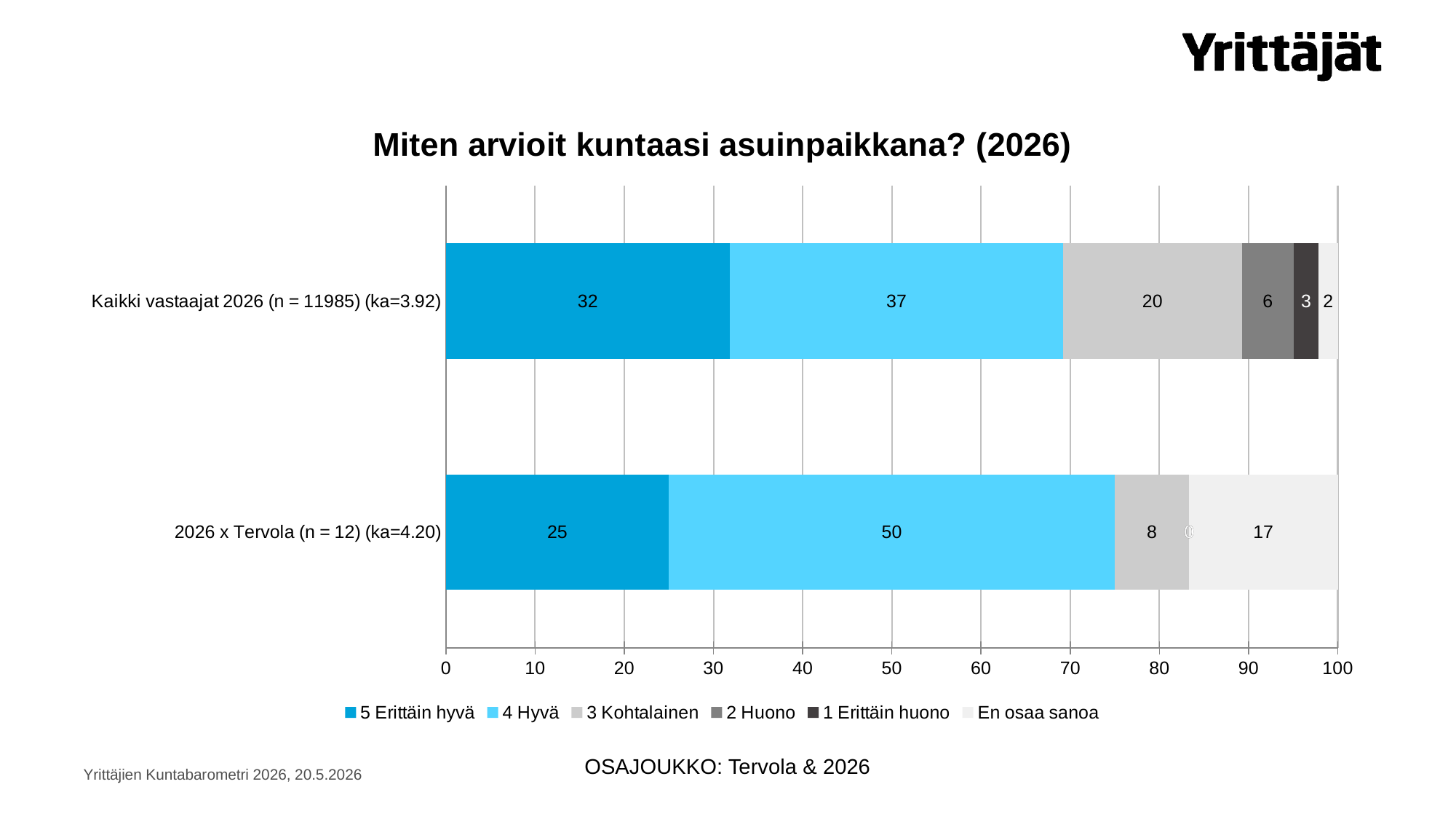
Which series has the largest value in the 'Kaikki vastaajat 2026 (n = 11985) (ka=3.92)' bar? 4 Hyvä How many series does the legend list? 6 What kind of chart is shown on the slide? stacked bar chart What is the value of '5 Erittäin hyvä' for 'Kaikki vastaajat 2026 (n = 11985) (ka=3.92)'? 32 How many bars (categories) are plotted in the chart? 2 What is the difference between the '5 Erittäin hyvä' values of 'Kaikki vastaajat 2026 (n = 11985) (ka=3.92)' and '2026 x Tervola (n = 12) (ka=4.20)'? 7 Which category has the higher value for '4 Hyvä'? 2026 x Tervola (n = 12) (ka=4.20) What is the total of the stacked bar for 'Kaikki vastaajat 2026 (n = 11985) (ka=3.92)'? 100 What is the value of '3 Kohtalainen' for 'Kaikki vastaajat 2026 (n = 11985) (ka=3.92)'? 20 What is the value of 'En osaa sanoa' for '2026 x Tervola (n = 12) (ka=4.20)'? 17 What is the value of '4 Hyvä' for '2026 x Tervola (n = 12) (ka=4.20)'? 50 What is the chart's title? Miten arvioit kuntaasi asuinpaikkana? (2026)